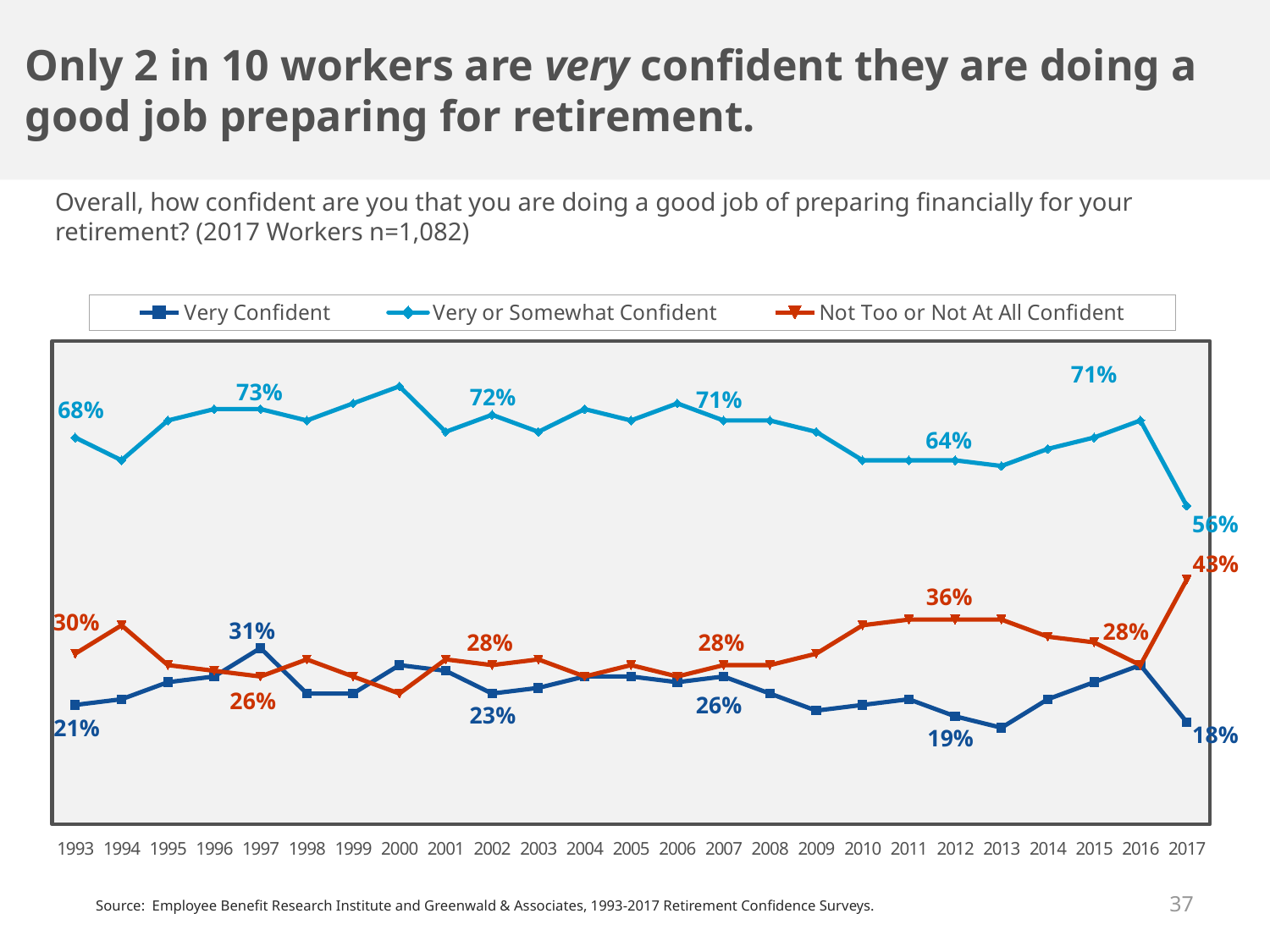
What is the value for Very Confident in 1993? 21% Does the Very or Somewhat Confident series rise or fall from 2016 to 2017? fall In which year does the Very Confident series reach its highest value? 1997 What kind of chart is shown on the slide? line chart How many series does the legend list? 3 What is the value for Very or Somewhat Confident in 2017? 56% What is the value for Not Too or Not At All Confident in 2017? 43% In which year does the Not Too or Not At All Confident series reach its highest value? 2017 What is the value for Not Too or Not At All Confident in 2012? 36% How many years are shown along the x axis? 25 What is the difference between Very or Somewhat Confident and Very Confident in 2017? 38 percentage points What is the value for Very Confident in 2017? 18%